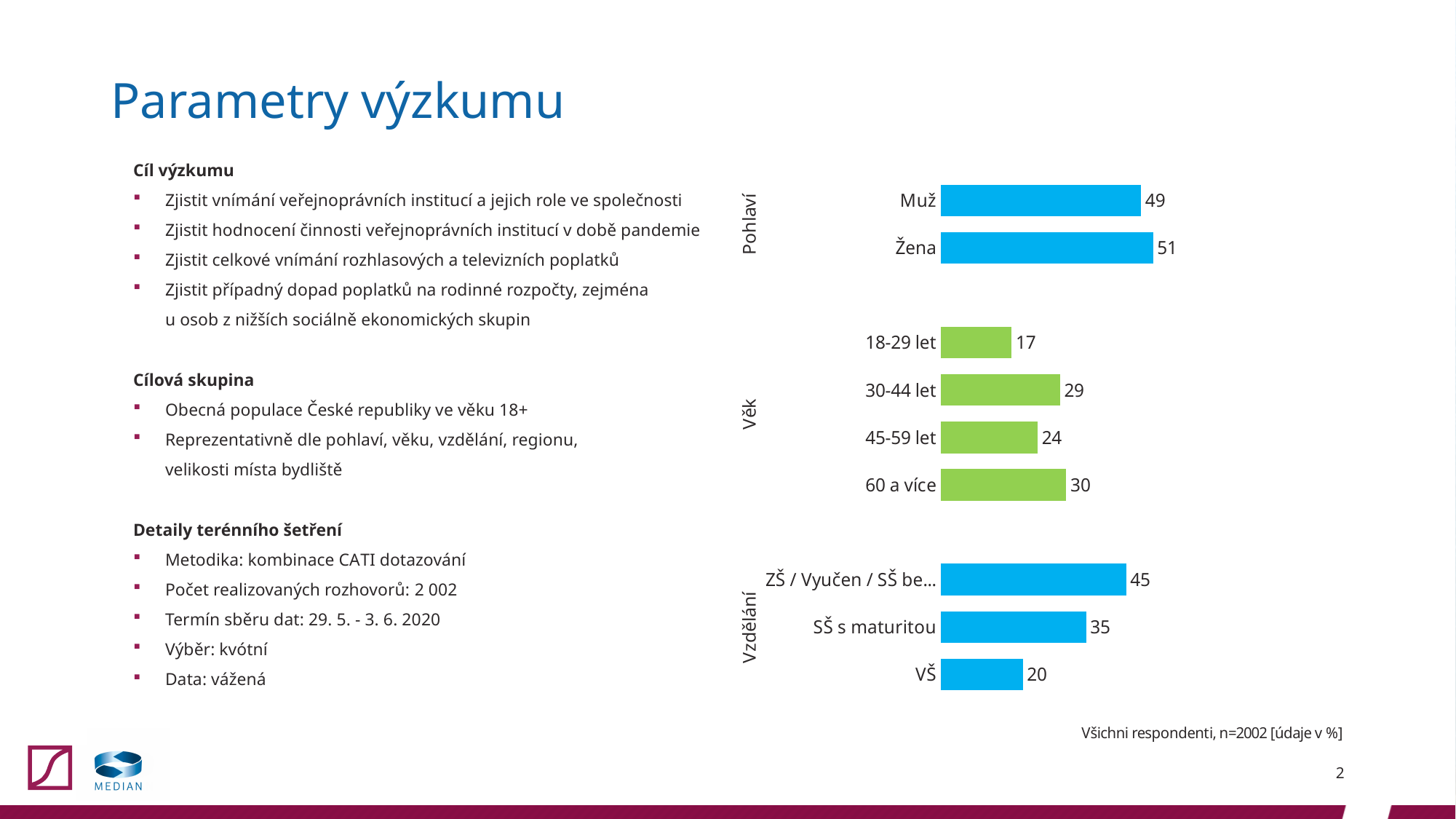
How many categories does the Věk chart show? 4 In the Věk chart, what is the difference between the values for 60 a více and 18-29 let? 13 In the Věk chart, what is the value for 30-44 let? 29 In the Vzdělání chart, what is the difference between the values for ZŠ / Vyučen / SŠ be… and VŠ? 25 In the Pohlaví chart, what is the value for Žena? 51 In the Pohlaví chart, what is the value for Muž? 49 In the Vzdělání chart, which category has the lowest value? VŠ In the Věk chart, which age group has the highest value? 60 a více What type of chart is used for the Vzdělání data? bar chart In the Věk chart, which age group has the lowest value? 18-29 let In the Věk chart, which is larger, the value for 45-59 let or the value for 30-44 let? 30-44 let In the Vzdělání chart, what is the value for SŠ s maturitou? 35